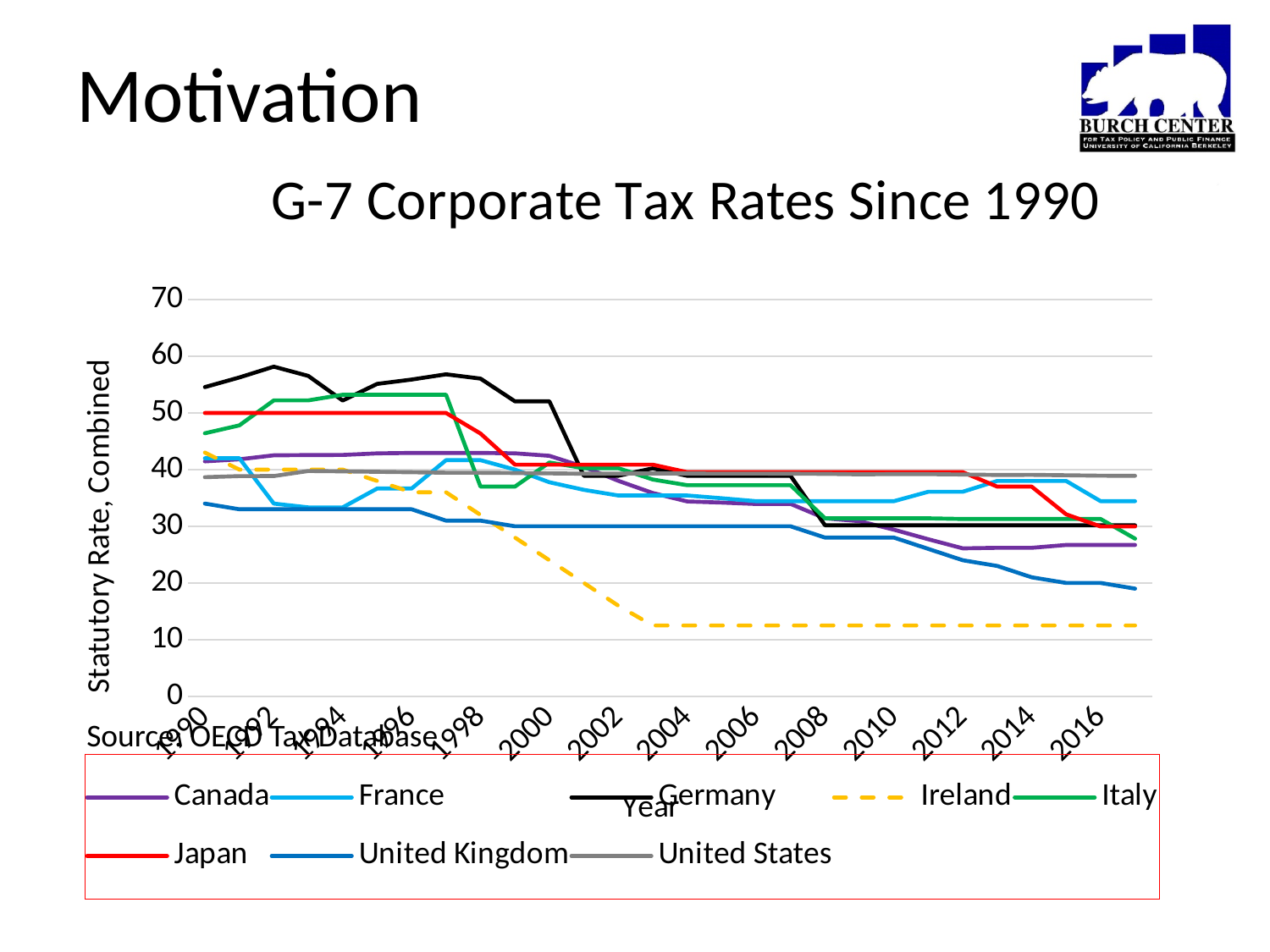
In 2010, which is larger, the value for Germany or the value for Ireland? Germany What kind of chart is shown on the slide? Line chart How many series does the legend list? 8 Does the value for Ireland rise or fall from 1990 to 2016? Fall Which country has the lowest corporate tax rate in 2016? Ireland What is the title of the chart? G-7 Corporate Tax Rates Since 1990 Is the value for Germany in 1992 greater or less than 50? greater Is the value for Canada in 2016 greater or less than 30? less Is the value for the United States in 2016 greater or less than 30? greater Which country has the highest corporate tax rate in 1992? Germany Which series is drawn with a dashed line? Ireland